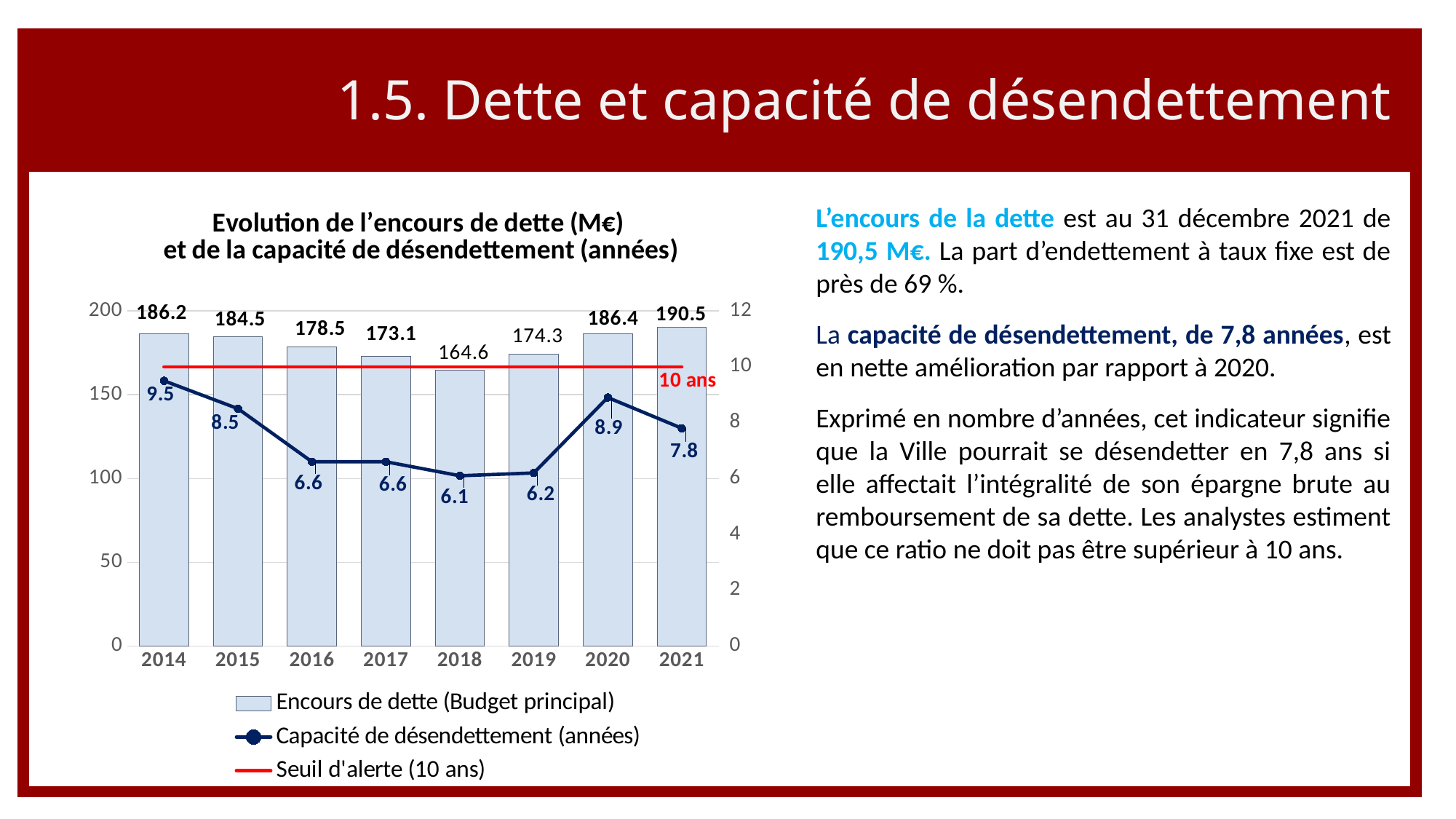
What value does the Seuil d'alerte line represent? 10 ans Which year has the lowest Encours de dette? 2018 How many years are shown on the x axis? 8 Which year has the highest Capacité de désendettement? 2014 What is the Encours de dette value for 2016? 178.5 Which year has the highest Encours de dette? 2021 What is the Capacité de désendettement (années) value for 2018? 6.1 What is the difference in Encours de dette between 2021 and 2020? 4.1 How many series does the legend list? 3 Does the Capacité de désendettement rise or fall from 2014 to 2018? fall Which is larger, the Capacité de désendettement in 2020 or in 2021? 2020 What is the value of Encours de dette (Budget principal) for 2021? 190.5